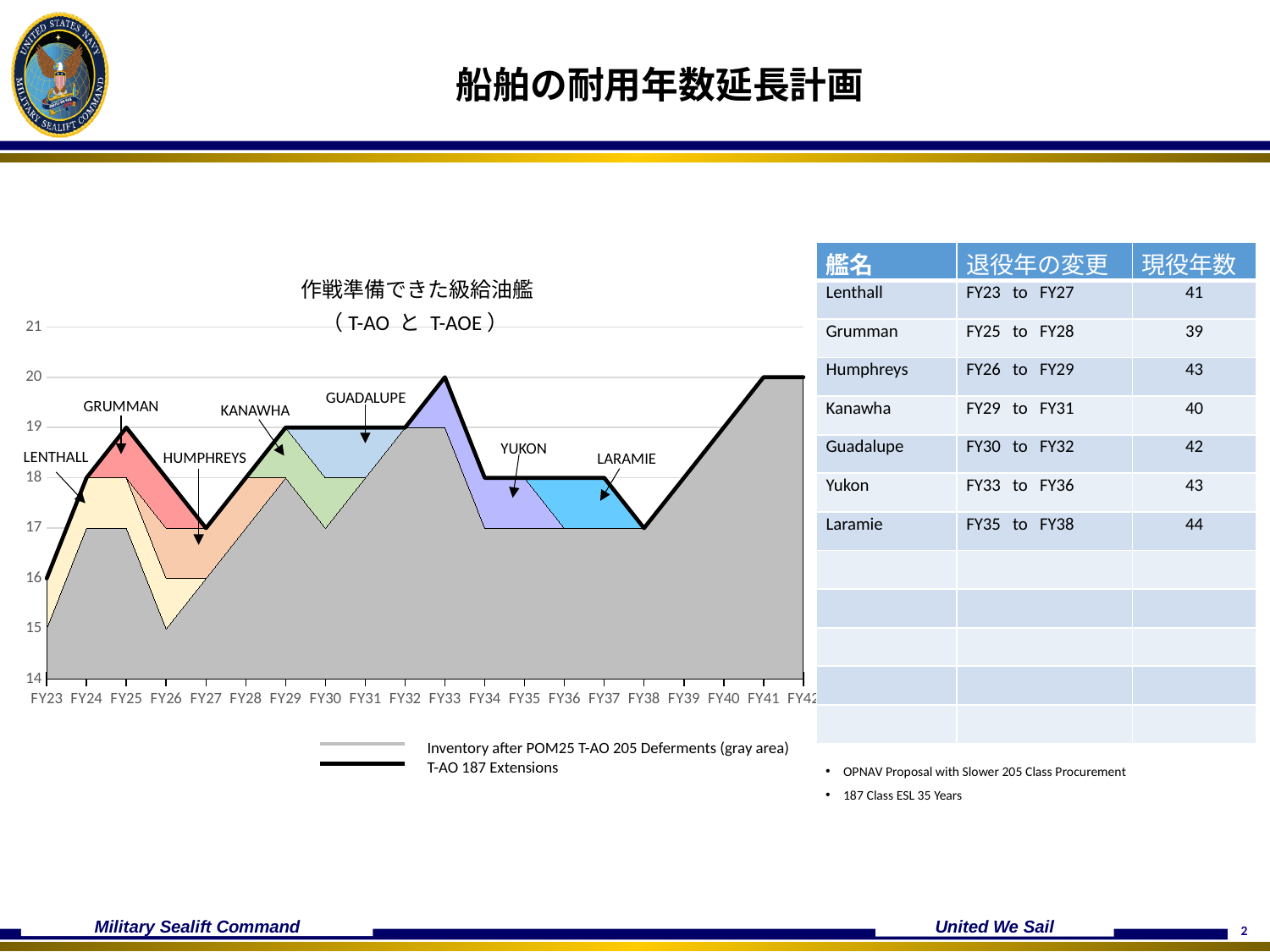
How many ship names are labelled on the chart? 7 Which is larger on the T-AO 187 Extensions line, the value at FY25 or the value at FY26? FY25 How many series does the chart legend list? 2 How many fiscal years are shown along the x axis of the chart? 20 What does the gray area in the chart represent, according to the legend? Inventory after POM25 T-AO 205 Deferments What is the value of the T-AO 187 Extensions line at FY33? 20 Is the value of the gray area at FY26 greater or less than 16? less What kind of chart is shown on the slide? area chart In which fiscal year is the T-AO 187 Extensions line at its lowest? FY23 What is the value of the T-AO 187 Extensions line at FY23? 16 Is the value of the T-AO 187 Extensions line at FY33 greater or less than 19? greater Does the T-AO 187 Extensions line rise or fall from FY38 to FY41? rise